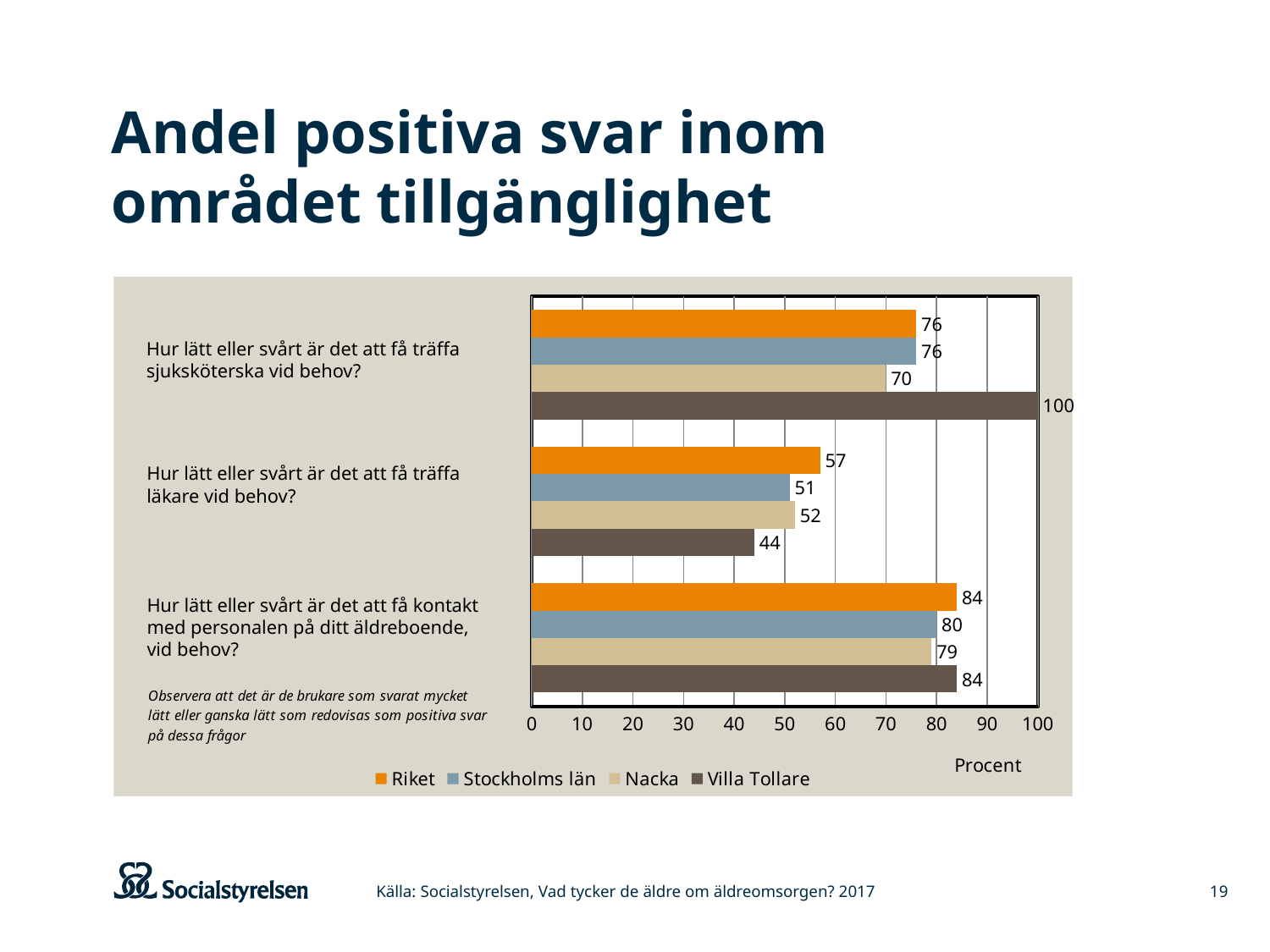
What is the difference between Riket and Villa Tollare on the question about meeting a doctor ("träffa läkare vid behov")? 13 What is the value for Nacka on the question "Hur lätt eller svårt är det att få träffa läkare vid behov?"? 52 What kind of chart is shown on the slide? Bar chart What is the value for Stockholms län on the question about getting in contact with staff at the care home ("få kontakt med personalen på ditt äldreboende")? 80 Which is larger on the question about meeting a doctor ("träffa läkare vid behov"): Riket or Stockholms län? Riket Which series has the highest value on the question "Hur lätt eller svårt är det att få träffa sjuksköterska vid behov?"? Villa Tollare Which series has the lowest value on the question "Hur lätt eller svårt är det att få träffa läkare vid behov?"? Villa Tollare How many question categories are shown on the chart? 3 What is the label of the x axis? Procent What is the difference between Villa Tollare and Nacka on the question about meeting a nurse ("träffa sjuksköterska vid behov")? 30 How many series does the legend list? 4 What is the value for Villa Tollare on the question "Hur lätt eller svårt är det att få träffa sjuksköterska vid behov?"? 100